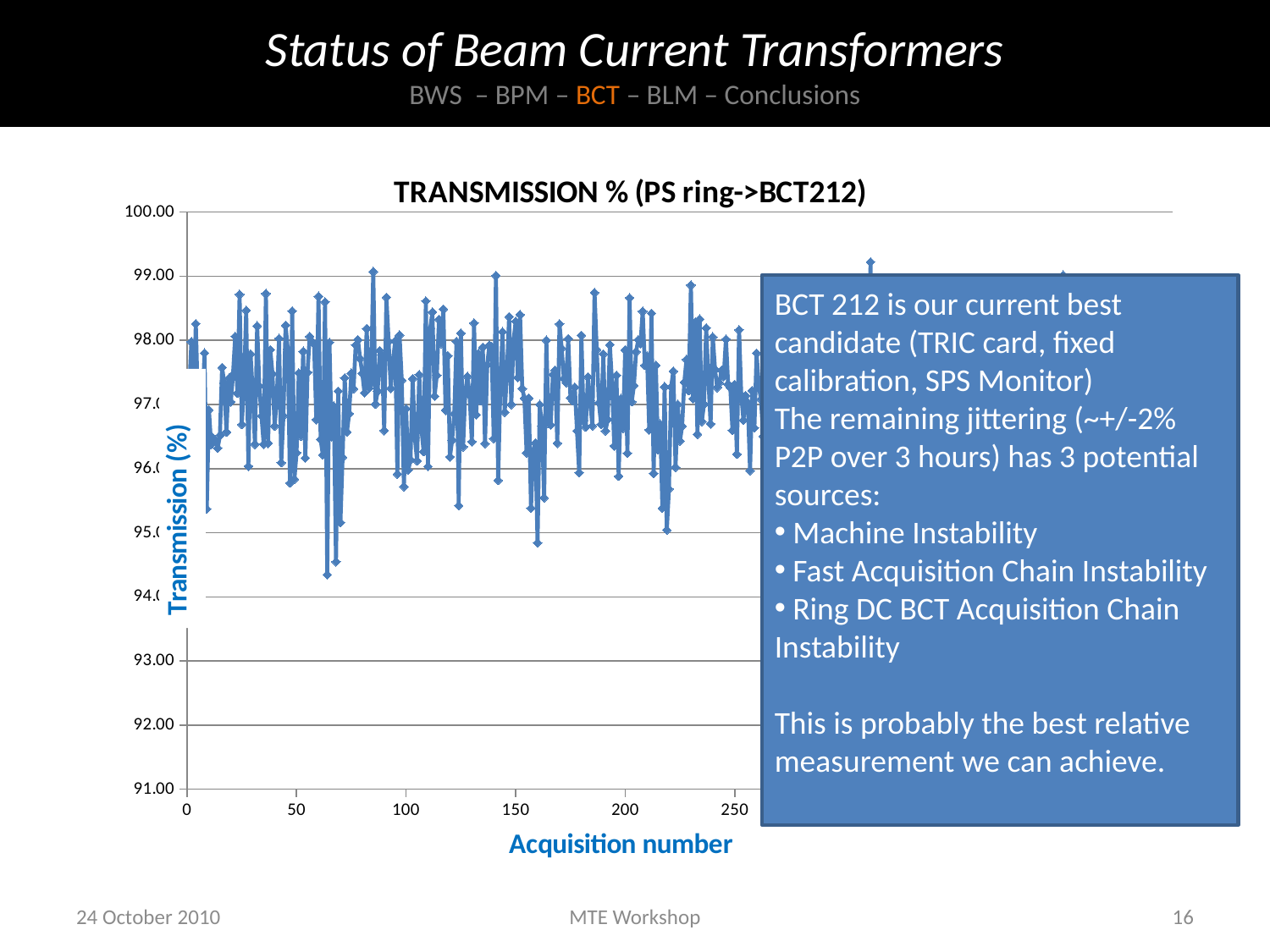
Is the transmission value at acquisition number 0 greater or less than 97.00? greater Are all plotted transmission values greater or less than 93.00? greater Do the transmission values show a steady rise, a steady fall, or do they fluctuate along the x axis? fluctuate Is the highest plotted transmission value greater or less than 99.00? greater What kind of chart is shown on the slide? line chart What is the lowest value shown on the y axis of the chart? 91.00 What is the title of the chart? TRANSMISSION % (PS ring->BCT212) What is the label of the x axis of the chart? Acquisition number